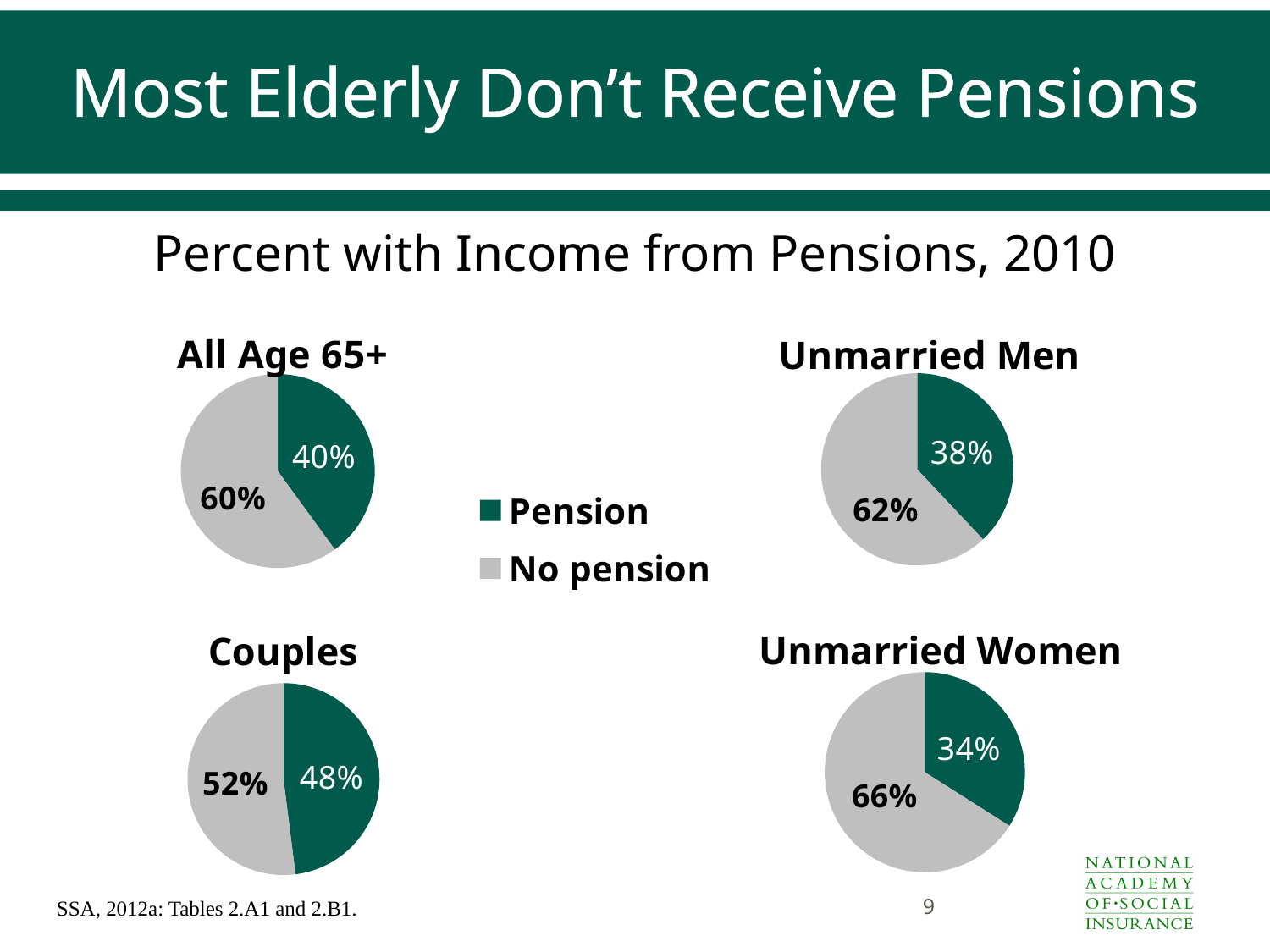
What type of chart is used on this slide? Pie chart In the 'Couples' pie chart, what percent have a pension? 48% How many pie charts are on the slide? 4 In the 'All Age 65+' pie chart, what percent have income from pensions? 40% Across the four pie charts, which group has the lowest percent with a pension? Unmarried Women Which is larger: the 'Pension' share for Couples or the 'Pension' share for Unmarried Men? Couples How many series does the legend list? 2 In the 'Unmarried Men' pie chart, what share has no pension? 62% What colour represents 'No pension' in the pie charts? Gray In the 'Unmarried Men' pie chart, what is the difference between the 'No pension' share and the 'Pension' share? 24% Across the four pie charts, which group has the highest percent with a pension? Couples In the 'Unmarried Women' pie chart, what share has no pension? 66%